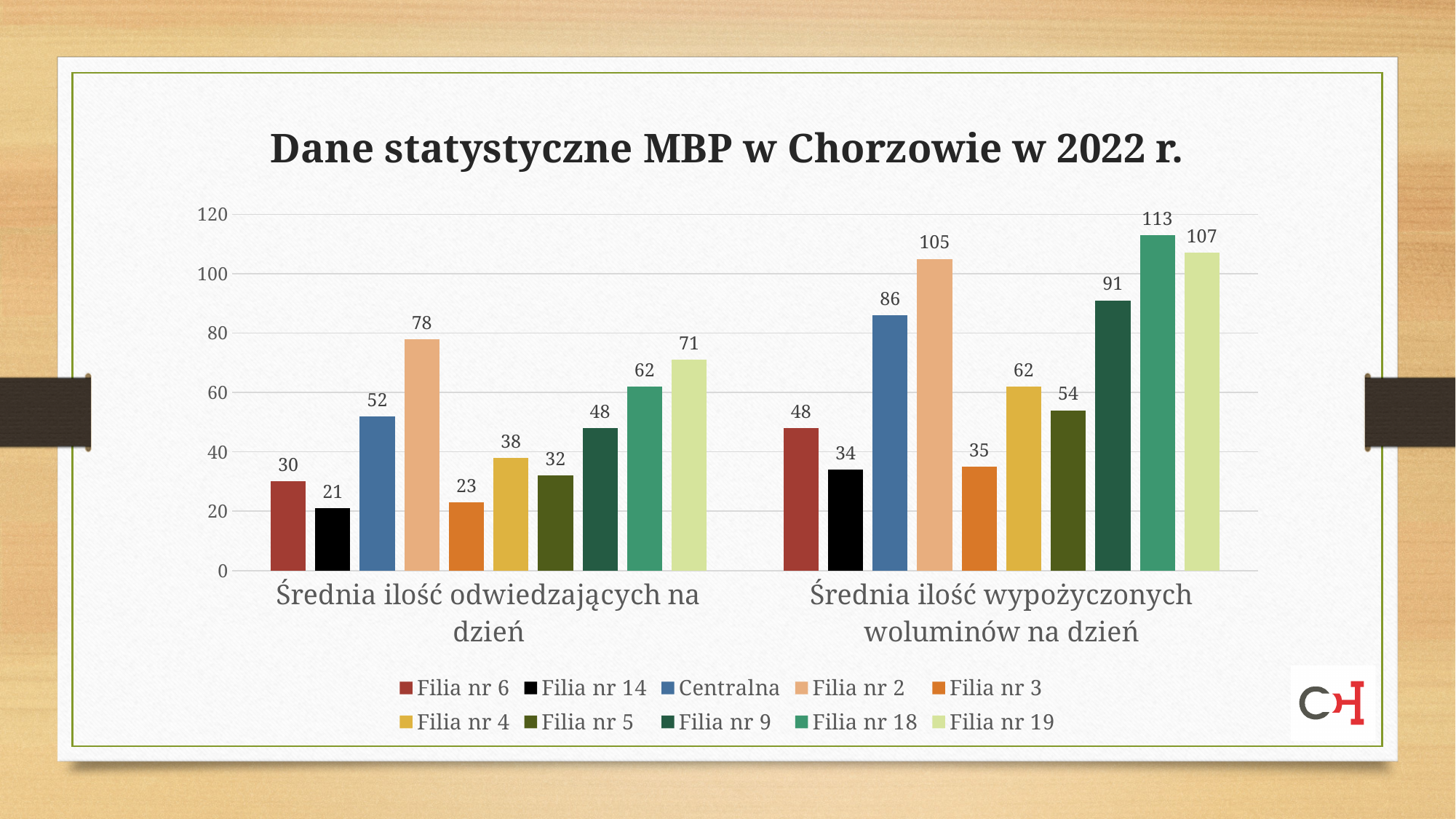
What is the value for Filia nr 2 in the 'Średnia ilość odwiedzających na dzień' category? 78 What is the title of the chart? Dane statystyczne MBP w Chorzowie w 2022 r. What is the difference between Filia nr 19 and Filia nr 9 in the 'Średnia ilość wypożyczonych woluminów na dzień' category? 16 What kind of chart is shown on the slide? Bar chart Which is larger in the 'Średnia ilość odwiedzających na dzień' category: Filia nr 4 or Filia nr 5? Filia nr 4 Which series has the lowest value in the 'Średnia ilość wypożyczonych woluminów na dzień' category? Filia nr 14 What is the value for Filia nr 18 in the 'Średnia ilość wypożyczonych woluminów na dzień' category? 113 How many series does the legend list? 10 Which series has the highest value in the 'Średnia ilość odwiedzających na dzień' category? Filia nr 2 Is the value for Filia nr 2 in the 'Średnia ilość wypożyczonych woluminów na dzień' category greater or less than 100? greater What is the value for Centralna in the 'Średnia ilość wypożyczonych woluminów na dzień' category? 86 How many categories are shown on the x axis? 2